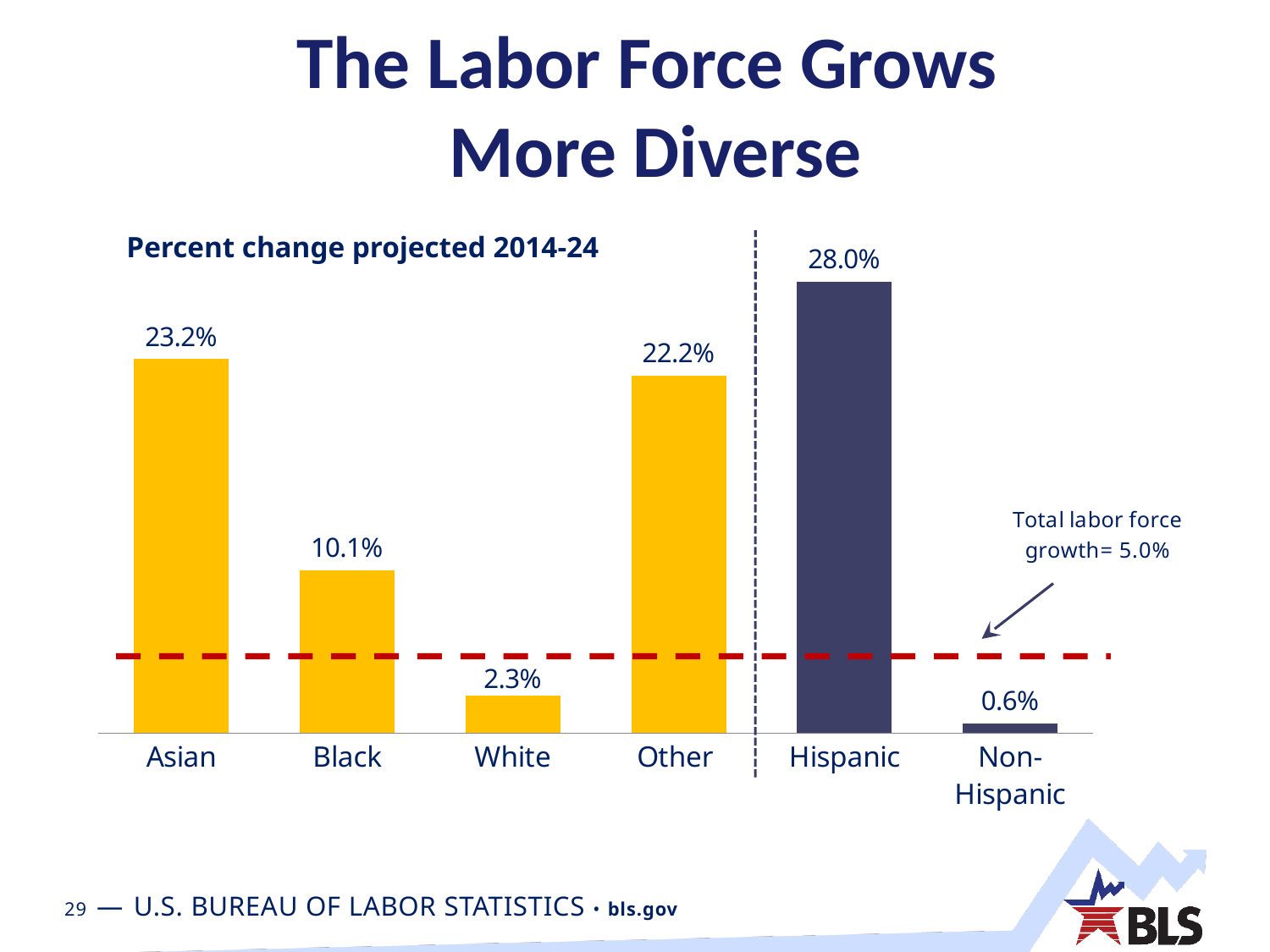
Which has a larger projected percent change, Asian or Other? Asian What total labor force growth value does the dashed red line represent? 5.0% Which category has the highest projected percent change? Hispanic What is the projected percent change for Asian? 23.2% What is the difference between the projected percent change for Hispanic and Non-Hispanic? 27.4% What kind of chart is shown on the slide? Bar chart What is the projected percent change for White? 2.3% What is the projected percent change for Non-Hispanic? 0.6% How many categories are shown in the chart? 6 What is the difference between the projected percent change for Asian and Black? 13.1% Which category has the lowest projected percent change? Non-Hispanic What is the projected percent change for Hispanic? 28.0%